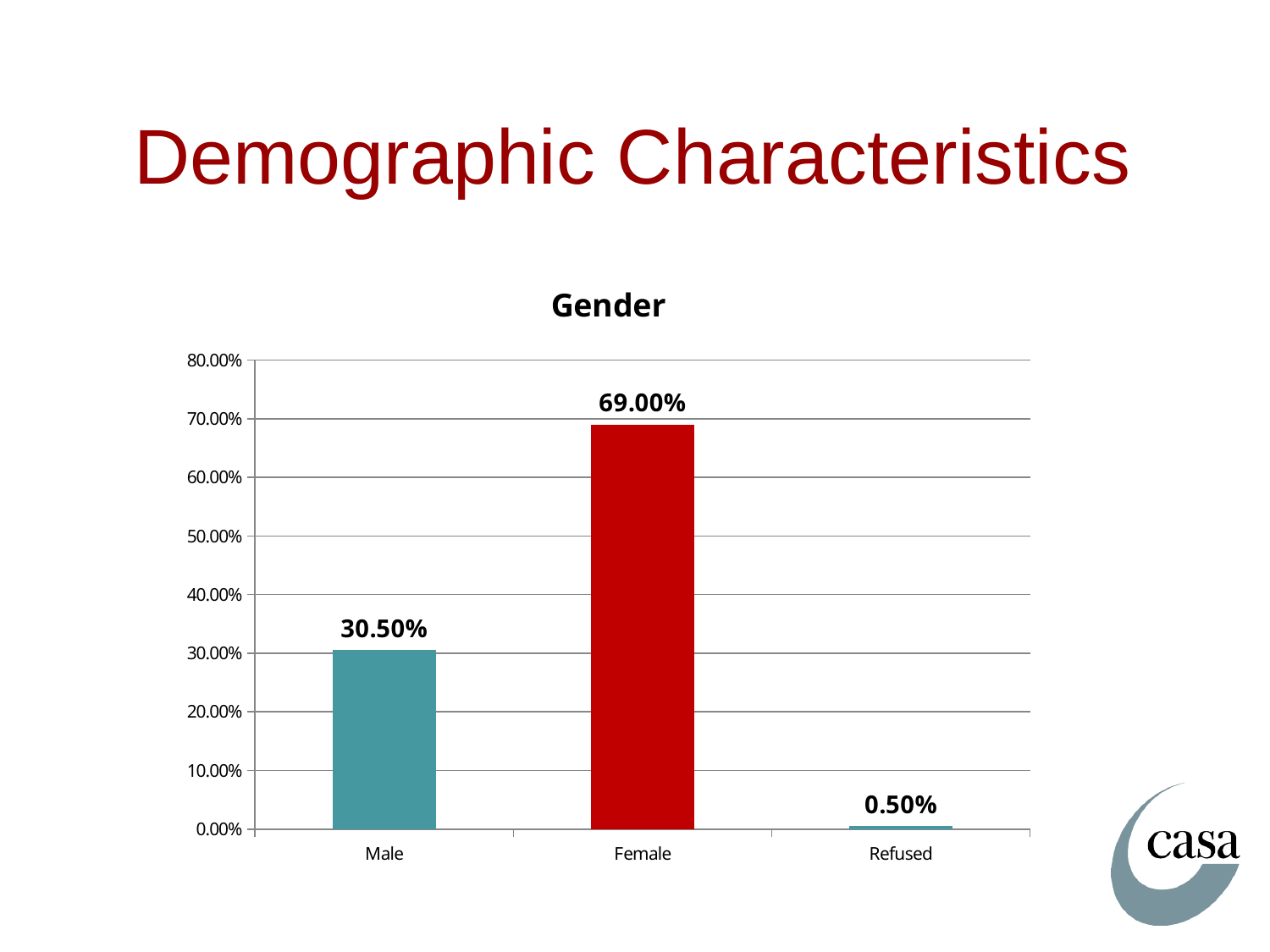
What kind of chart is the Gender chart? bar chart What is the value for Refused in the Gender chart? 0.50% Which category has the highest value in the Gender chart? Female Which is larger in the Gender chart, the value for Male or the value for Female? Female How many categories are shown in the Gender chart? 3 Which category has the lowest value in the Gender chart? Refused Is the value for Male in the Gender chart greater or less than 40.00%? less What is the value for Male in the Gender chart? 30.50% What colour is the Female bar in the Gender chart? red What is the difference between the Female and Male values in the Gender chart? 38.50% What is the title of the chart on the slide? Gender What is the value for Female in the Gender chart? 69.00%